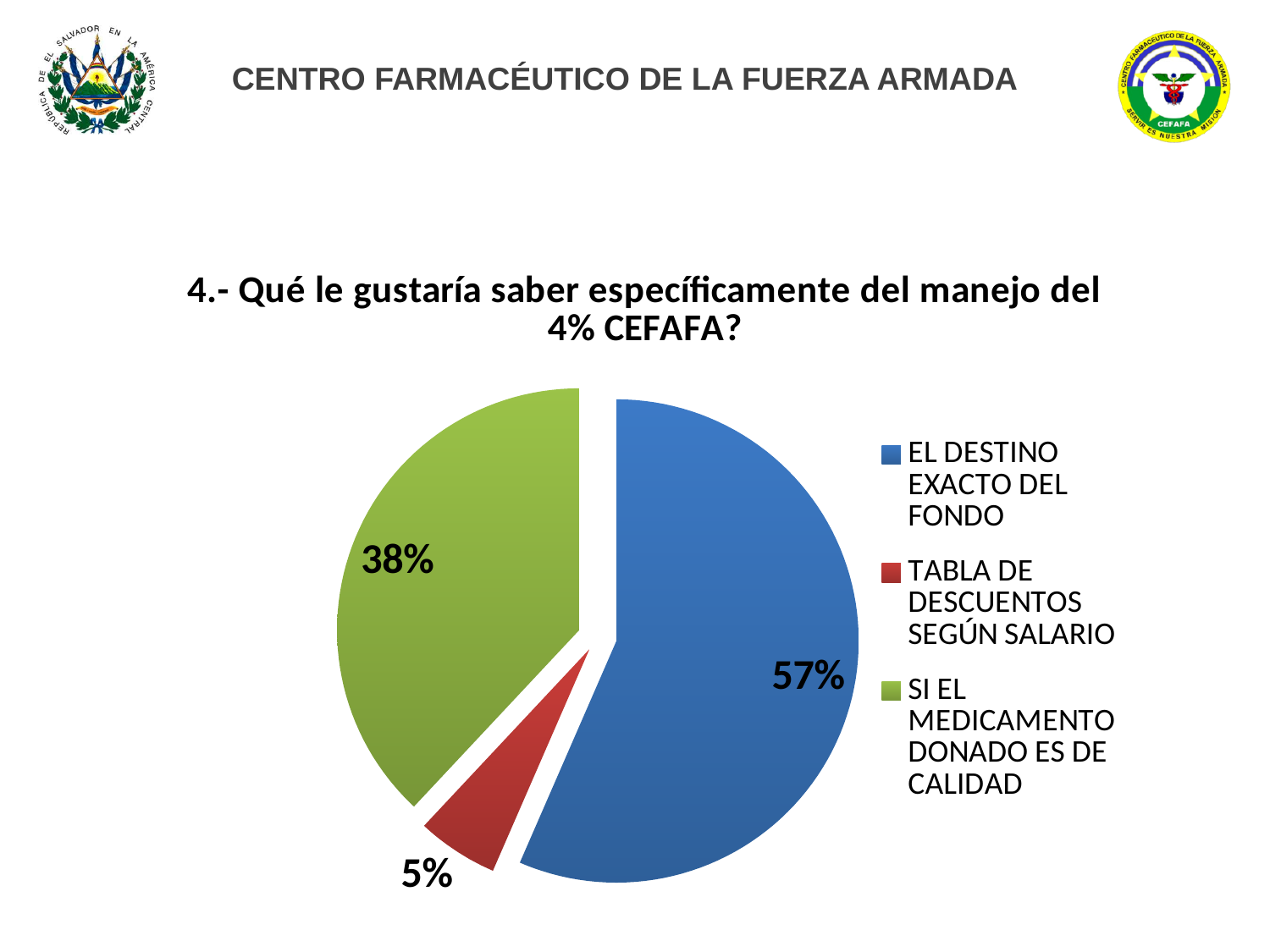
What share of the pie does "TABLA DE DESCUENTOS SEGÚN SALARIO" represent? 5% What share of the pie does "SI EL MEDICAMENTO DONADO ES DE CALIDAD" represent? 38% Which category has the largest slice of the pie? EL DESTINO EXACTO DEL FONDO Which category has the smallest slice of the pie? TABLA DE DESCUENTOS SEGÚN SALARIO What share of the pie does "EL DESTINO EXACTO DEL FONDO" represent? 57% Which is larger: the slice for "SI EL MEDICAMENTO DONADO ES DE CALIDAD" or the slice for "TABLA DE DESCUENTOS SEGÚN SALARIO"? SI EL MEDICAMENTO DONADO ES DE CALIDAD What is the difference in percentage points between "EL DESTINO EXACTO DEL FONDO" and "SI EL MEDICAMENTO DONADO ES DE CALIDAD"? 19% What kind of chart is shown on the slide? pie chart What is the title of the chart? 4.- Qué le gustaría saber específicamente del manejo del 4% CEFAFA? What is the difference in percentage points between "SI EL MEDICAMENTO DONADO ES DE CALIDAD" and "TABLA DE DESCUENTOS SEGÚN SALARIO"? 33% How many slices does the pie chart have? 3 What colour is the slice for "SI EL MEDICAMENTO DONADO ES DE CALIDAD"? green